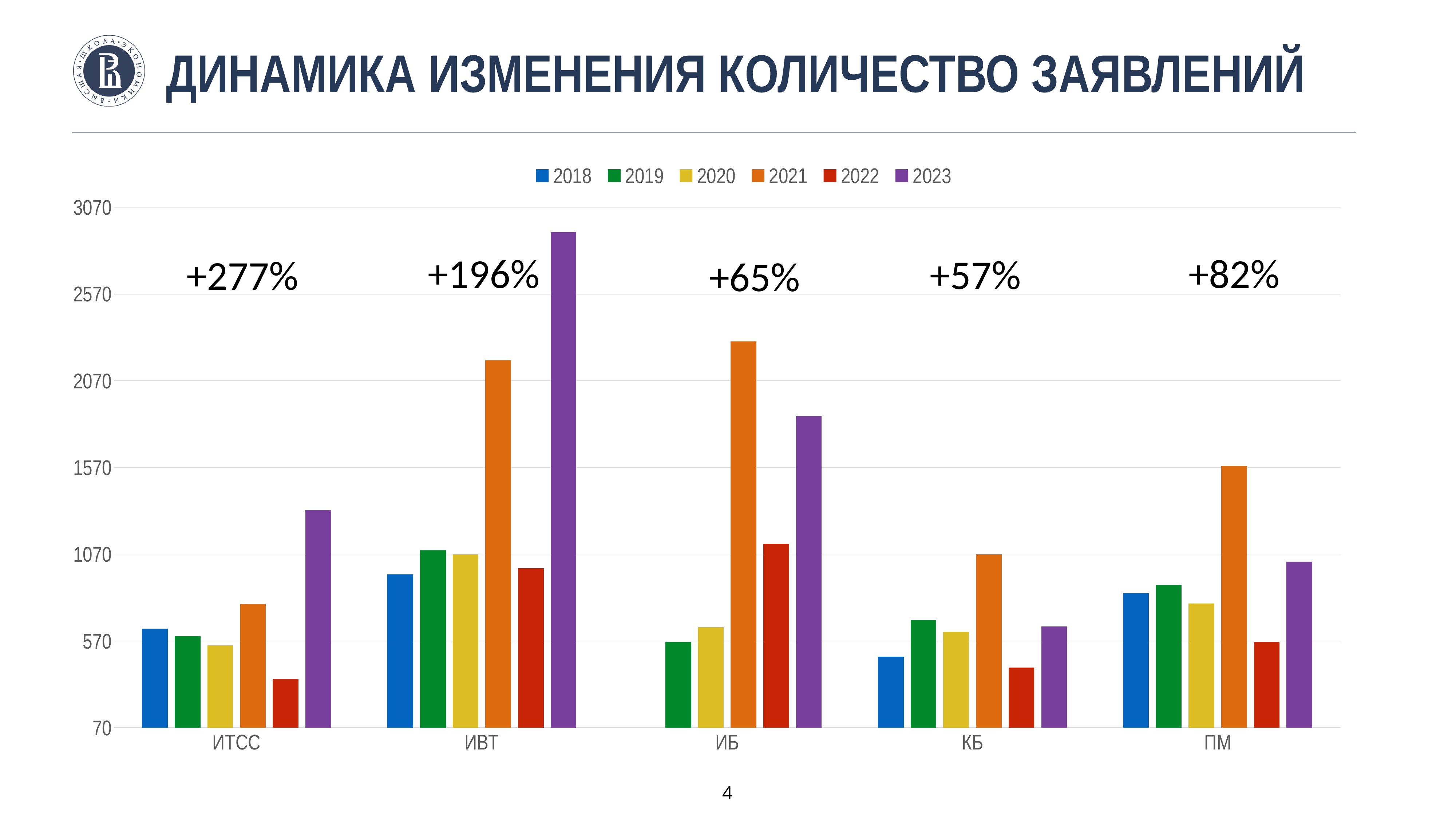
For ИТСС, which is larger: the 2021 value or the 2023 value? 2023 How many categories are shown on the x axis? 5 What percentage change is printed above the ИТСС group? +277% Which category has the lowest value for 2023? КБ How many series does the legend list? 6 Is the 2023 value for ИВТ greater or less than 2570? greater Is the 2023 value for ИБ greater or less than 1570? greater What kind of chart is shown on the slide? bar chart Which category has the highest value for 2023? ИВТ For ИБ, which is larger: the 2021 value or the 2023 value? 2021 Is the 2022 value for ИТСС greater or less than 570? less Which series has no bar in the ИБ group? 2018